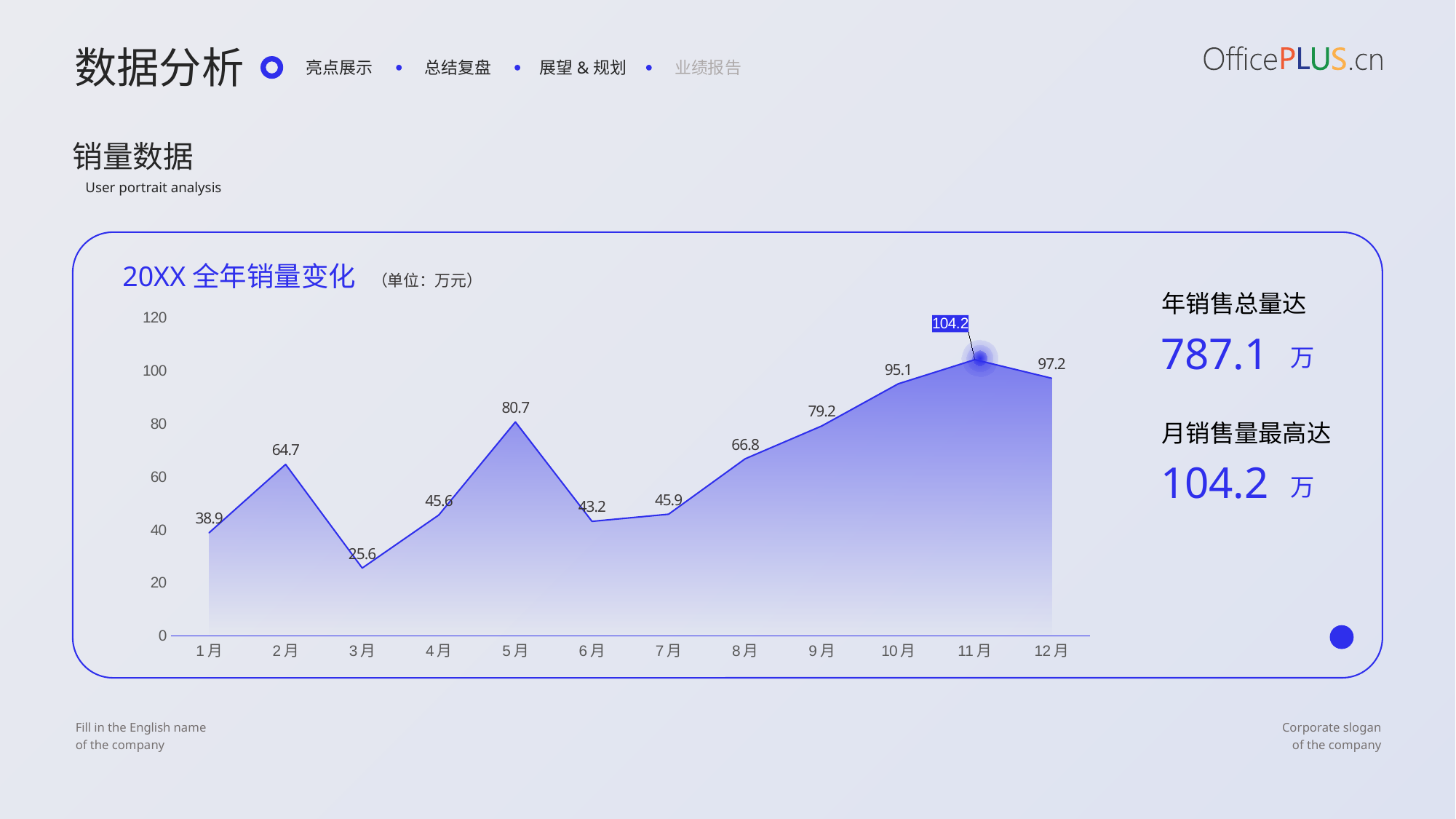
What is the value for 5月 in the 20XX 全年销量变化 chart? 80.7 Which month has the lowest value in the 20XX 全年销量变化 chart? 3月 Is the value for 10月 in the 20XX 全年销量变化 chart greater or less than 80? greater What is the difference between the values for 2月 and 3月 in the 20XX 全年销量变化 chart? 39.1 What is the value for 9月 in the 20XX 全年销量变化 chart? 79.2 What kind of chart is the 20XX 全年销量变化 chart? area chart What unit is stated next to the title of the 20XX 全年销量变化 chart? 万元 What is the value for 1月 in the 20XX 全年销量变化 chart? 38.9 What is the difference between the values for 11月 and 12月 in the 20XX 全年销量变化 chart? 7.0 Which month has the highest value in the 20XX 全年销量变化 chart? 11月 How many months are plotted in the 20XX 全年销量变化 chart? 12 Which is larger in the 20XX 全年销量变化 chart, the value for 6月 or the value for 7月? 7月